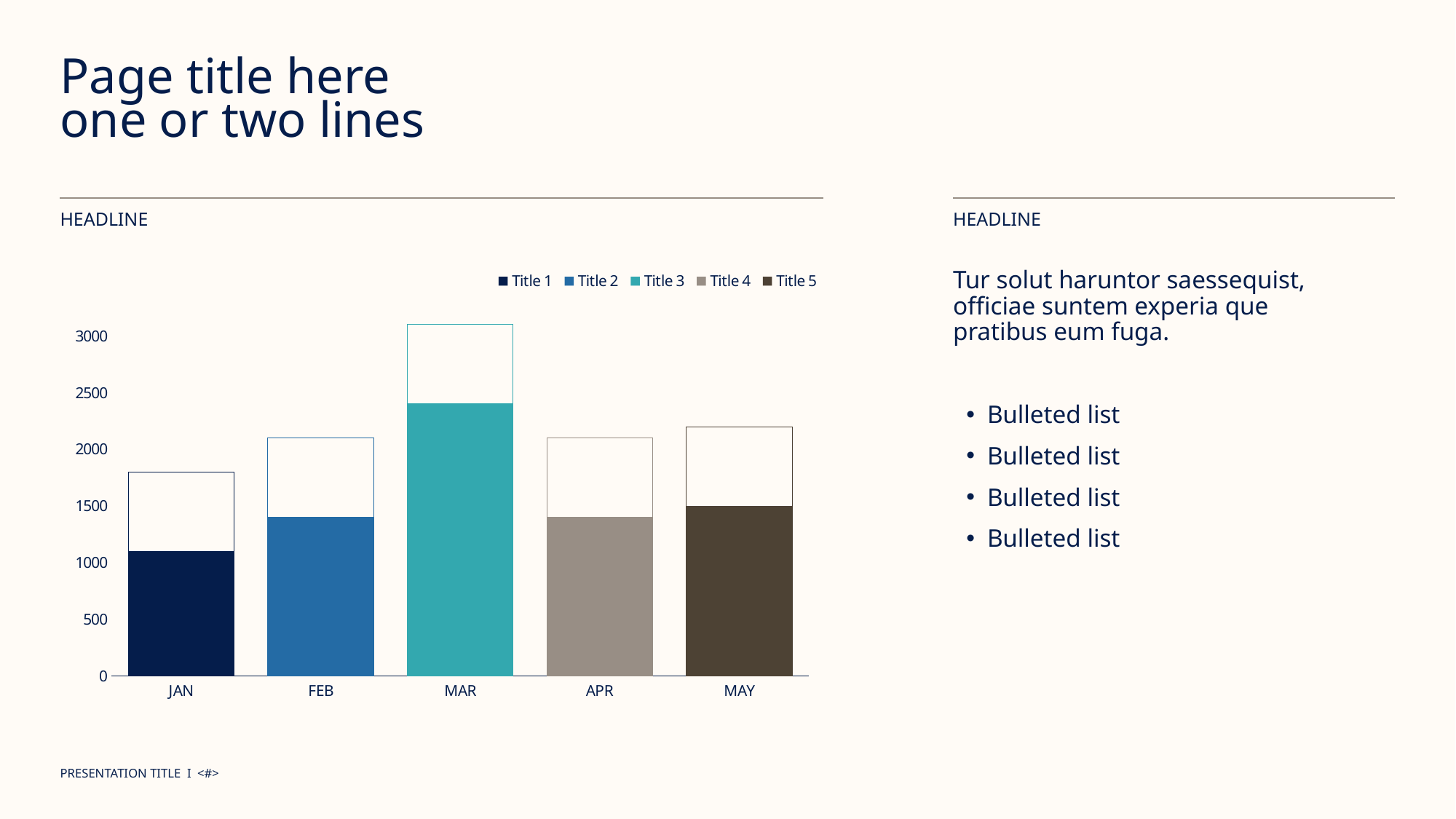
What kind of chart is shown on the slide? bar chart Which bar is taller, MAR or JAN? MAR How many series does the chart's legend list? 5 Is the value of the filled bar for FEB greater or less than 1500? less What is the first entry in the chart's legend? Title 1 How many categories are shown on the x axis of the chart? 5 Is the value of the filled bar for JAN greater or less than 1000? greater Which month has the shortest bar in the chart? JAN Is the top of the outlined bar for MAR greater or less than 3000? greater Which bar is taller, MAY or JAN? MAY Which month has the tallest bar in the chart? MAR